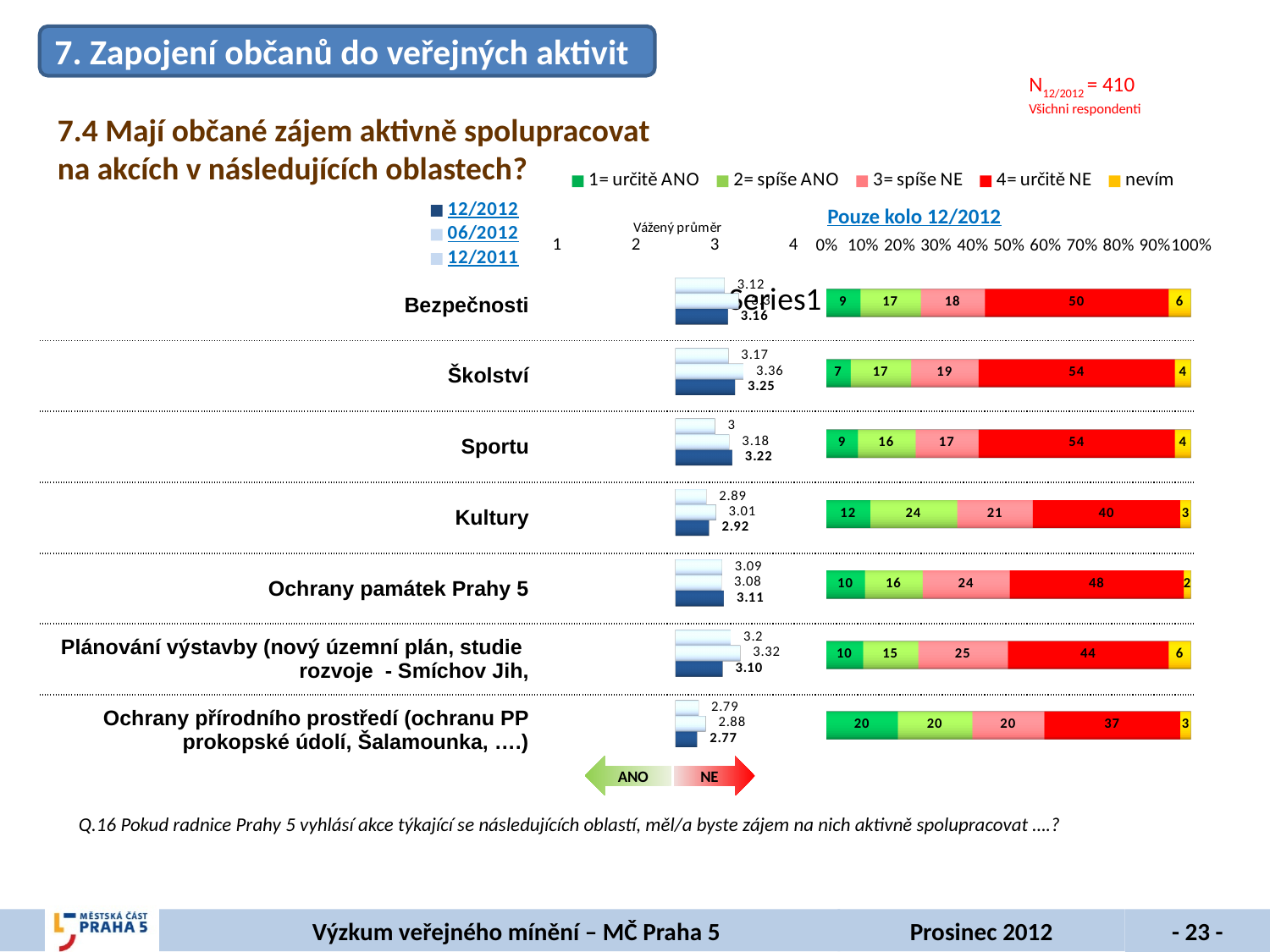
In the stacked bar chart 'Pouze kolo 12/2012', which category has the highest value for '1= určitě ANO'? Ochrany přírodního prostředí (ochranu PP prokopské údolí, Šalamounka, ….) How many categories are shown in the stacked bar chart 'Pouze kolo 12/2012'? 7 In the stacked bar chart 'Pouze kolo 12/2012', what is the value of '4= určitě NE' for Bezpečnosti? 50 How many series does the legend of the stacked bar chart 'Pouze kolo 12/2012' list? 5 How many series does the legend of the 'Vážený průměr' chart list? 3 In the stacked bar chart 'Pouze kolo 12/2012', which category has the lowest value for '4= určitě NE'? Ochrany přírodního prostředí (ochranu PP prokopské údolí, Šalamounka, ….) In the stacked bar chart 'Pouze kolo 12/2012', which has the larger '3= spíše NE' value: Plánování výstavby or Sportu? Plánování výstavby In the 'Vážený průměr' chart, what is the 12/2012 value for Školství? 3.25 In the 'Vážený průměr' chart, which category has the lowest 12/2012 value? Ochrany přírodního prostředí (ochranu PP prokopské údolí, Šalamounka, ….) What type of chart is the 'Pouze kolo 12/2012' chart on the right? Stacked bar chart In the 'Vážený průměr' chart, which category has the highest 12/2012 value? Školství In the stacked bar chart 'Pouze kolo 12/2012', what is the difference between the '2= spíše ANO' value for Kultury and for Bezpečnosti? 7